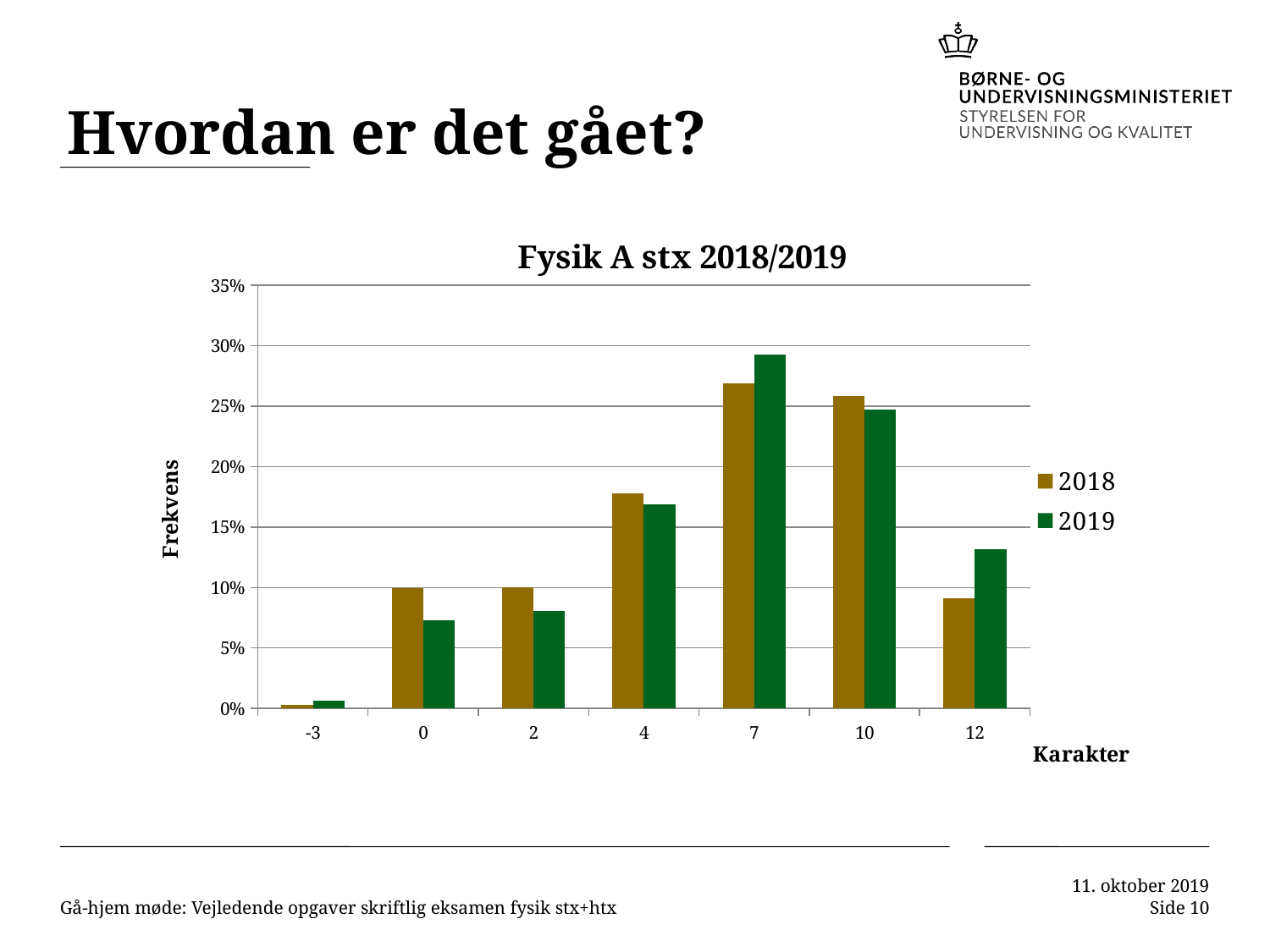
Which grade has the highest frequency for 2018? 7 Which grade has the lowest frequency for 2018? -3 Which grade has the highest frequency for 2019? 7 Is the 2018 value for grade 10 greater or less than 20%? greater Is the 2019 value for grade 7 greater or less than 25%? greater Is the 2019 value for grade 12 greater or less than 15%? less For grade 0, which year has the higher frequency, 2018 or 2019? 2018 What kind of chart is shown on the slide? bar chart What is the title of the chart? Fysik A stx 2018/2019 For grade 12, which year has the higher frequency, 2018 or 2019? 2019 How many grade categories (Karakter) are shown on the x axis? 7 How many series does the legend list? 2